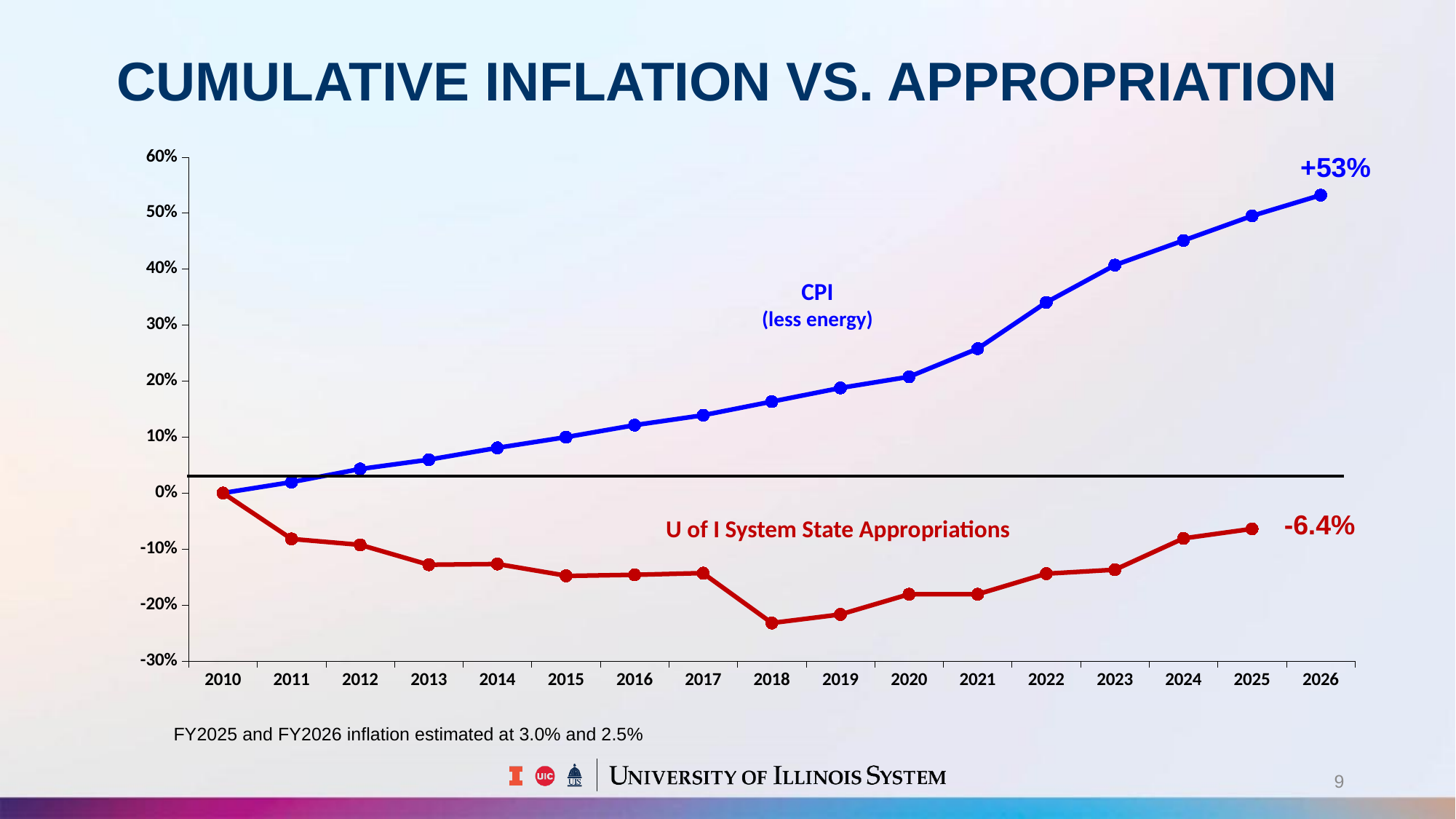
Is the CPI (less energy) value for 2024 greater or less than 40%? greater How many years are labeled along the x axis? 17 What is the cumulative CPI (less energy) value shown for 2026? +53% In which year does the U of I System State Appropriations line reach its lowest point? 2018 Which series is higher in 2025, CPI (less energy) or U of I System State Appropriations? CPI (less energy) How many data series are plotted on the chart? 2 What kind of chart is shown on the slide? line chart Does the CPI (less energy) line rise or fall from 2010 to 2026? rise Is the U of I System State Appropriations value for 2018 greater or less than -20%? less Is the CPI (less energy) value for 2021 greater or less than 20%? greater What is the value shown for U of I System State Appropriations at the end of its line (2025)? -6.4% What is the title of the chart on the slide? CUMULATIVE INFLATION VS. APPROPRIATION